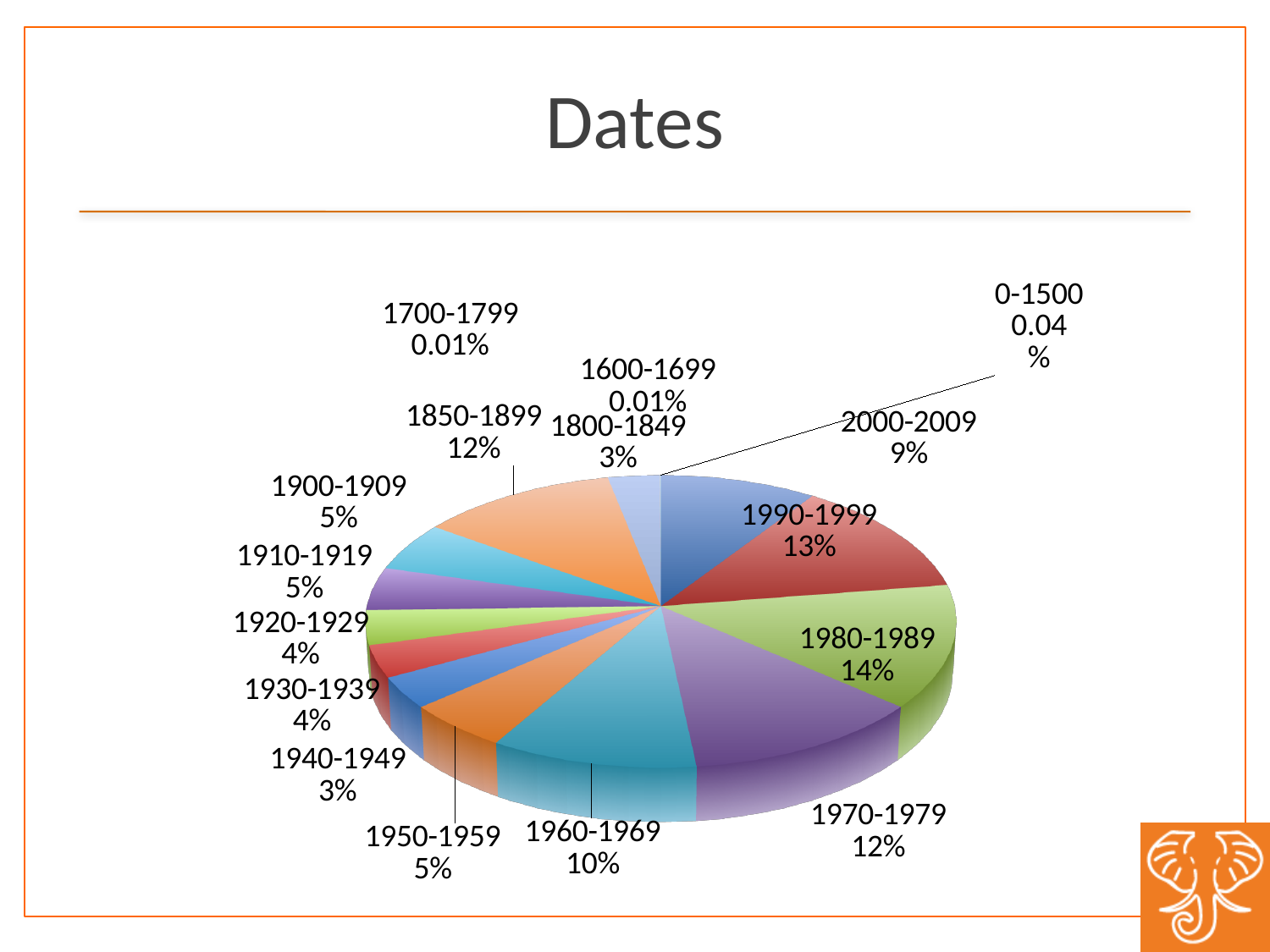
Which has a larger share, 1990-1999 or 1970-1979? 1990-1999 What percentage is shown for 1960-1969? 10% What percentage is shown for 0-1500? 0.04% What kind of chart is shown on the slide? pie chart Which date range has the largest share of the pie? 1980-1989 What percentage does the 1980-1989 slice represent? 14% What is the title of the chart? Dates Which has a larger share, 2000-2009 or 1960-1969? 1960-1969 How many date ranges are shown in the pie chart? 16 What percentage is shown for 1850-1899? 12% What is the difference in percentage points between 1850-1899 and 1800-1849? 9% What is the difference in percentage points between 1980-1989 and 1990-1999? 1%